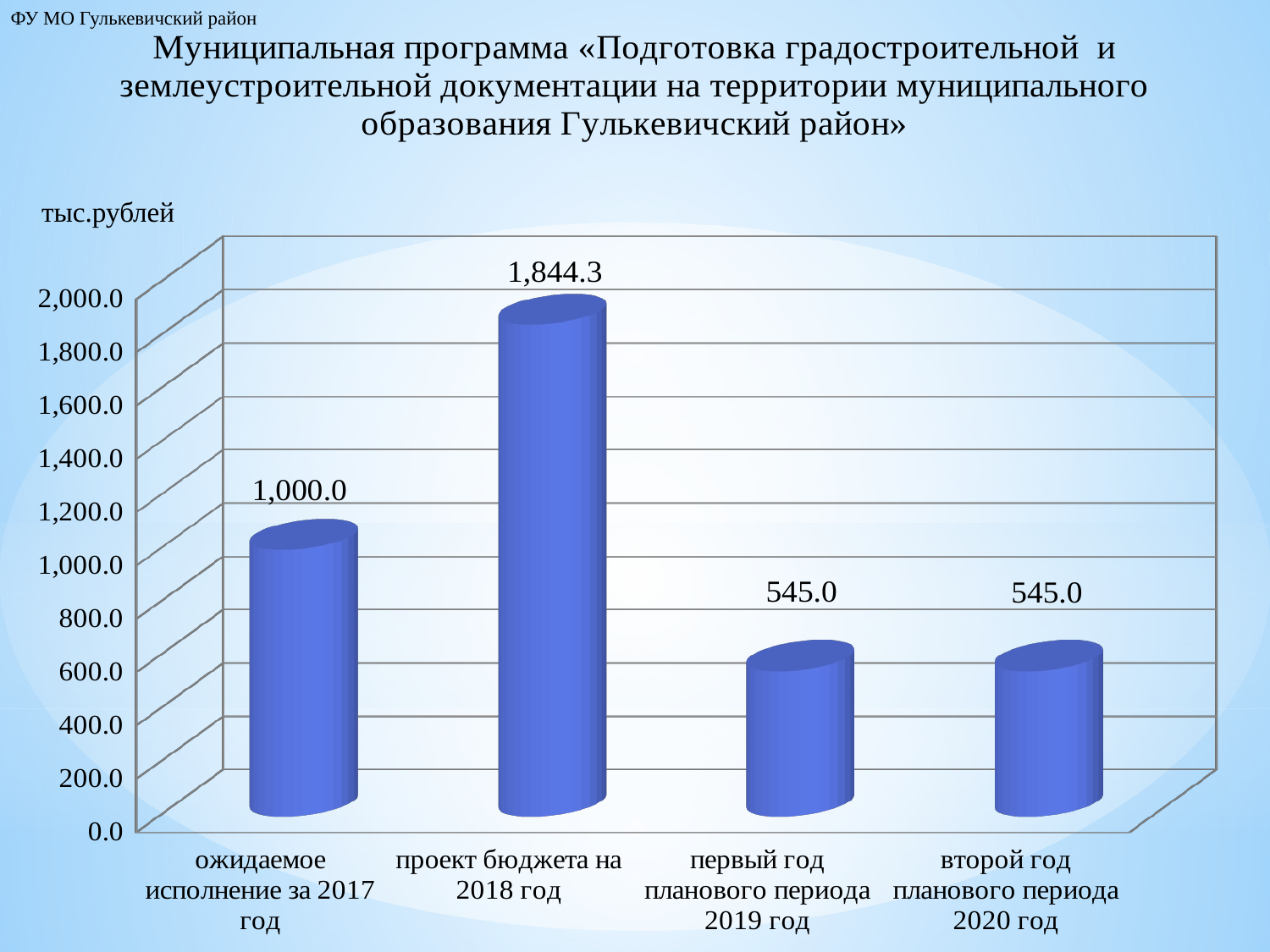
How many categories are shown on the chart? 4 Which is larger: the value for «ожидаемое исполнение за 2017 год» or the value for «первый год планового периода 2019 год»? ожидаемое исполнение за 2017 год What unit is indicated above the chart's vertical axis? тыс.рублей What is the value for «проект бюджета на 2018 год»? 1,844.3 Do the values rise or fall from «проект бюджета на 2018 год» to «второй год планового периода 2020 год»? fall What is the difference between the values for «ожидаемое исполнение за 2017 год» and «второй год планового периода 2020 год»? 455.0 What kind of chart is shown on the slide? bar chart Which category has the highest value? проект бюджета на 2018 год What is the difference between the values for «проект бюджета на 2018 год» and «ожидаемое исполнение за 2017 год»? 844.3 What is the value for «первый год планового периода 2019 год»? 545.0 What is the value for «ожидаемое исполнение за 2017 год»? 1,000.0 Is the value for «проект бюджета на 2018 год» greater or less than 1,600.0? greater